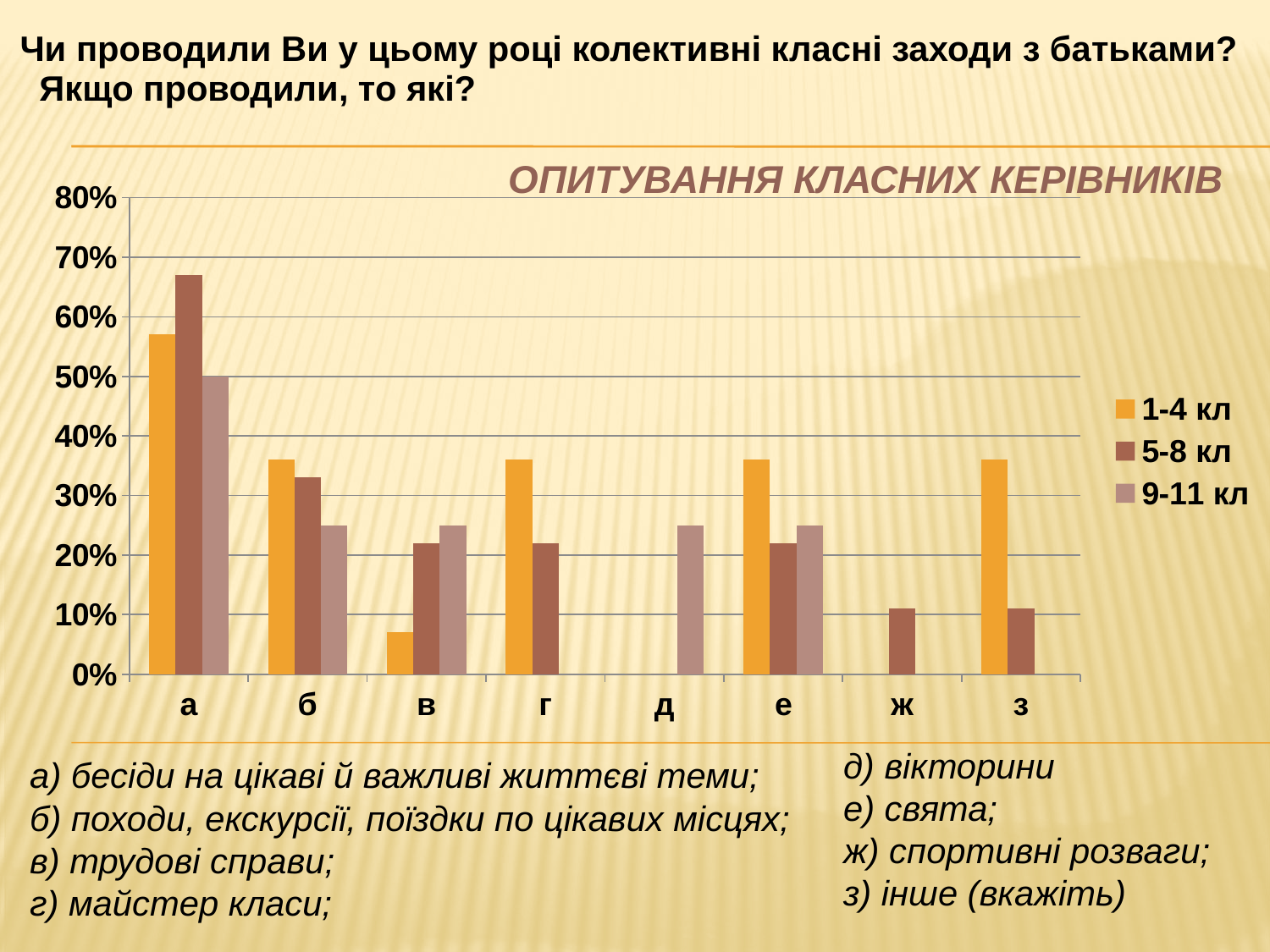
Is the value for 1-4 кл in category а greater or less than 50%? greater What are the three series names listed in the legend? 1-4 кл, 5-8 кл, 9-11 кл What kind of chart is shown on the slide? bar chart How many categories are shown on the x axis? 8 Is the value for 1-4 кл in category в greater or less than 10%? less In category а, which is larger: the 1-4 кл value or the 5-8 кл value? 5-8 кл Is the value for 5-8 кл in category а greater or less than 60%? greater How many series does the legend list? 3 Which category has the highest value for the 5-8 кл series? а Which is larger: the 1-4 кл value for category б or for category в? б Which is larger: the 9-11 кл value for category а or for category б? а